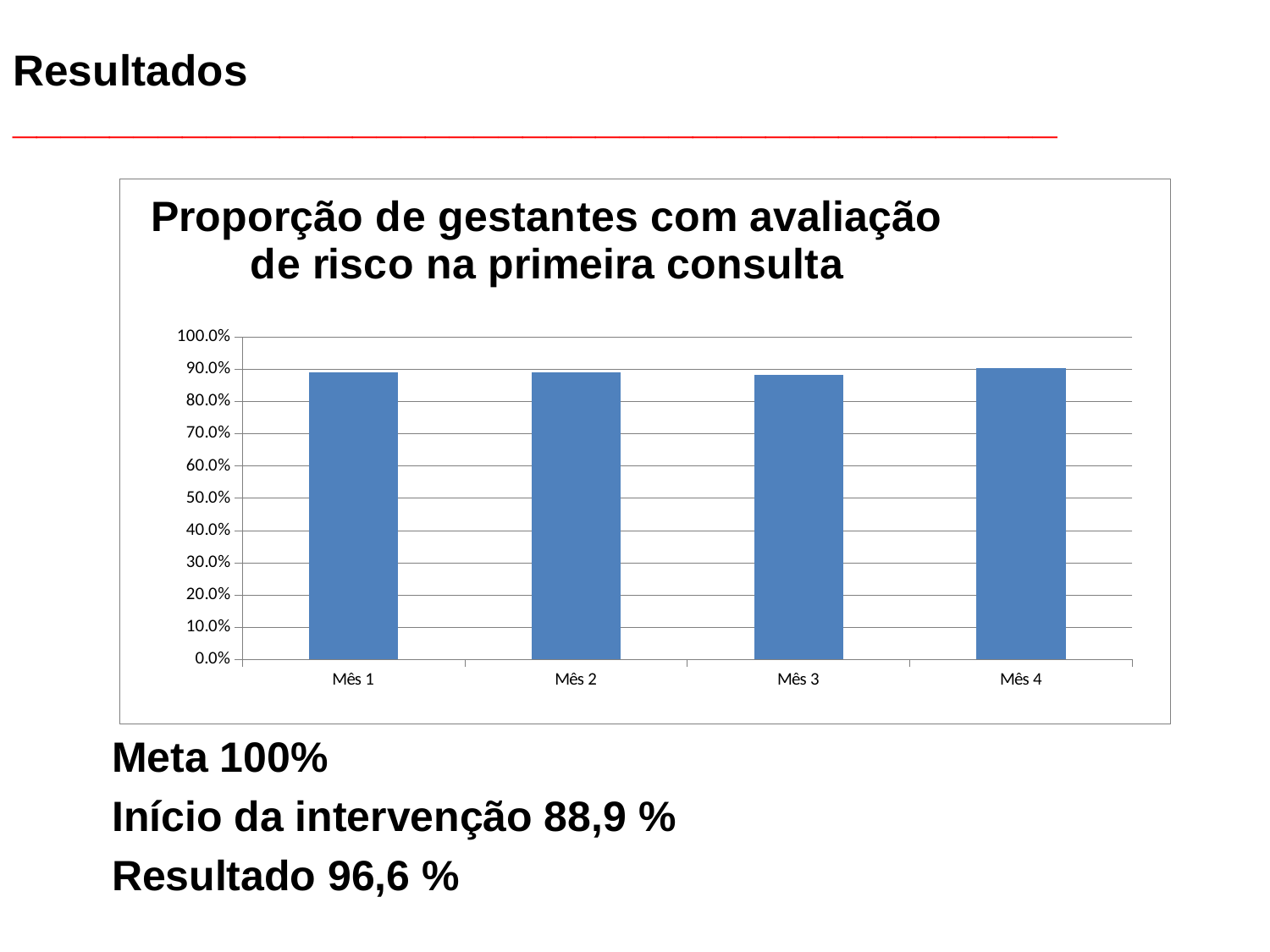
What is the label of the first category on the x axis? Mês 1 Is the value for Mês 4 greater or less than 80.0%? greater How many months (categories) are plotted on the chart? 4 What is the title of the chart? Proporção de gestantes com avaliação de risco na primeira consulta What is the highest value shown on the vertical axis of the chart? 100.0% Is the value for Mês 2 greater or less than 80.0%? greater Is the value for Mês 3 greater or less than 70.0%? greater What kind of chart is shown on the slide? bar chart